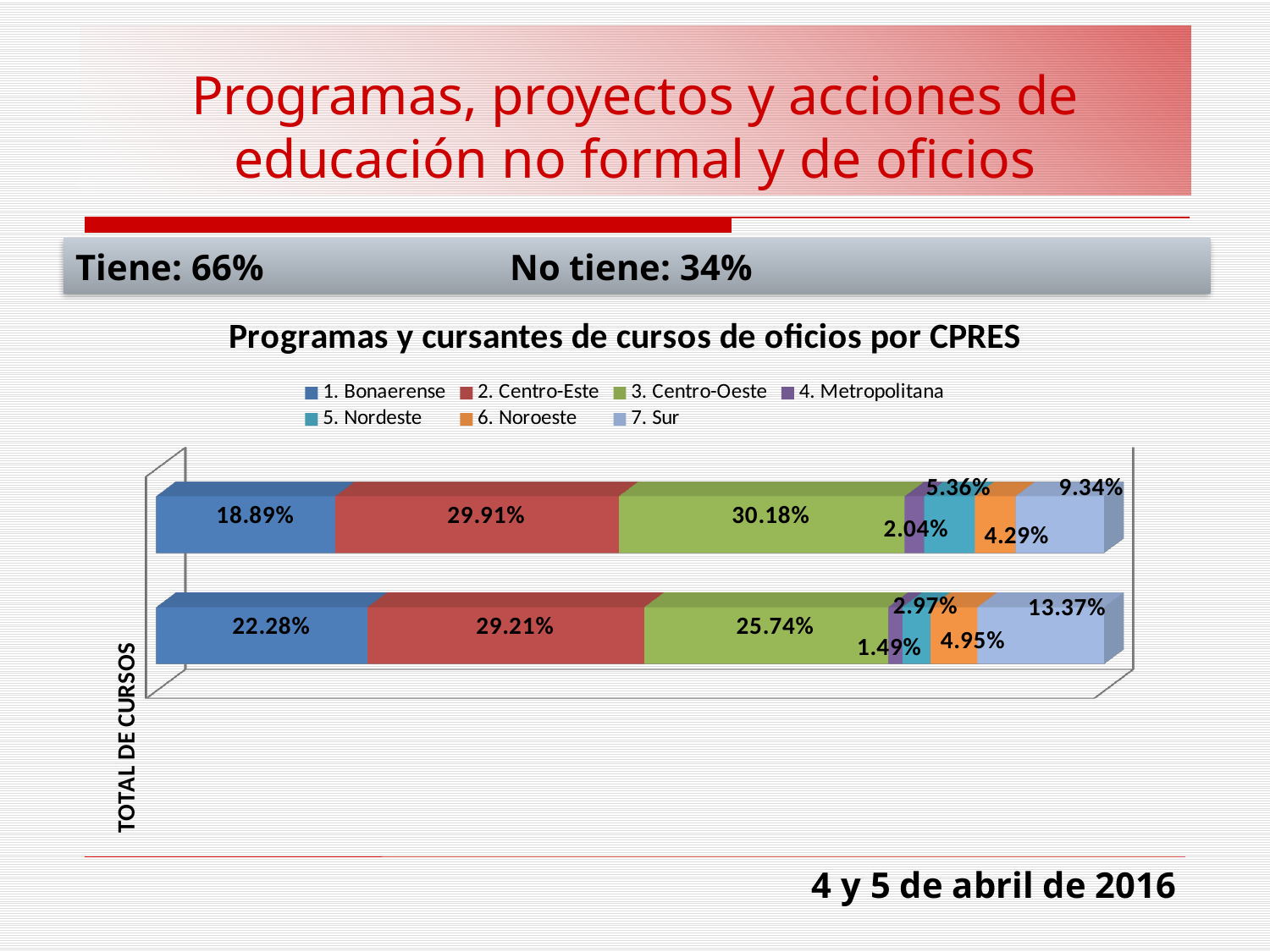
In the bar labelled TOTAL DE CURSOS, what is the value for 4. Metropolitana? 1.49% In the top bar, what is the difference between the values for 2. Centro-Este and 1. Bonaerense? 11.02 percentage points In the bar labelled TOTAL DE CURSOS, what is the value for 7. Sur? 13.37% In the top bar, which is larger: the value for 5. Nordeste or for 6. Noroeste? 5. Nordeste In the top bar, which series has the smallest segment? 4. Metropolitana Is the value for 1. Bonaerense larger in the top bar or in the TOTAL DE CURSOS bar? TOTAL DE CURSOS bar In the top bar, what is the value for 3. Centro-Oeste? 30.18% How many stacked bars are plotted in the chart? 2 What kind of chart is shown on the slide? Stacked bar chart In the bar labelled TOTAL DE CURSOS, what is the difference between the values for 7. Sur and 6. Noroeste? 8.42 percentage points How many series does the chart legend list? 7 In the bar labelled TOTAL DE CURSOS, which series has the largest segment? 2. Centro-Este